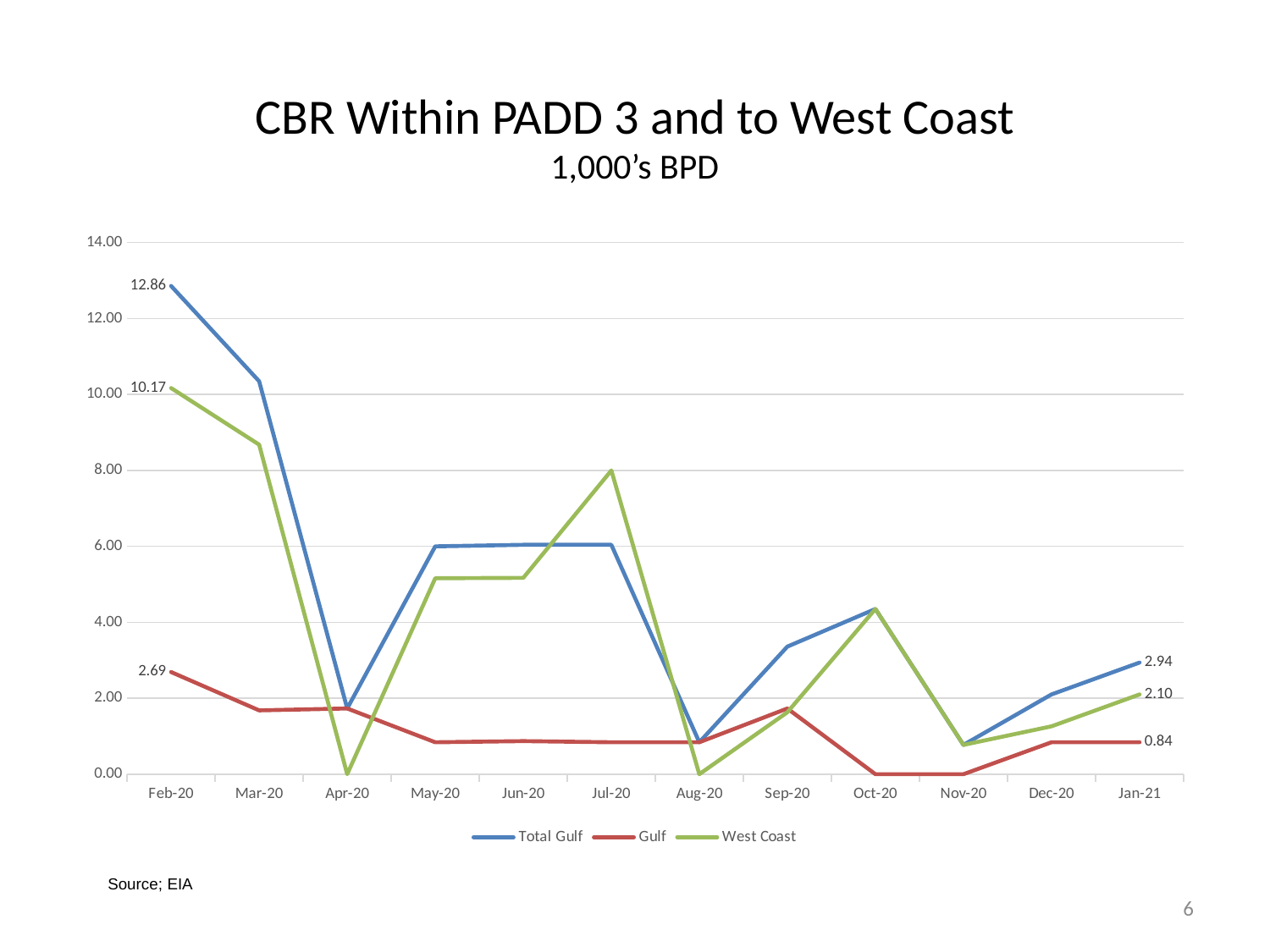
What is the value for West Coast in Jan-21? 2.10 How many series does the legend list? 3 By how much did the Total Gulf value fall from Feb-20 (12.86) to Jan-21 (2.94)? 9.92 What is the value for Gulf in Feb-20? 2.69 How many months are plotted on the x axis? 12 What is the value for Gulf in Jan-21? 0.84 What kind of chart is shown on the slide? line chart Is the value for West Coast in Jul-20 greater or less than 6.00? greater What is the difference between the Total Gulf value and the West Coast value in Feb-20? 2.69 Is the value for Total Gulf in Apr-20 greater or less than 4.00? less What is the value for Total Gulf in Feb-20? 12.86 Which series has the higher value in Jan-21, Total Gulf or Gulf? Total Gulf